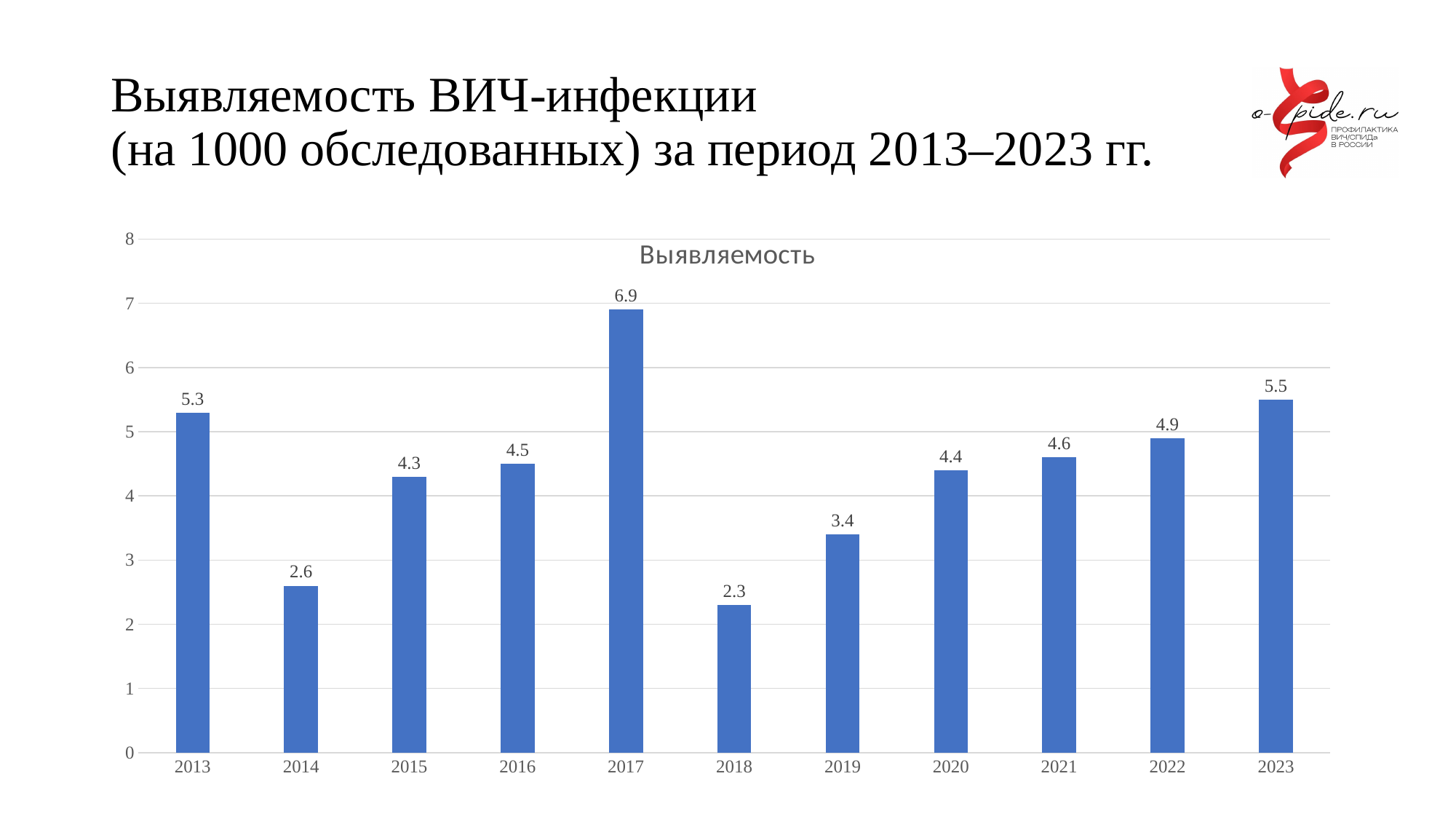
Which is larger, the value for 2013 or the value for 2022? 2013 What is the title shown inside the chart area? Выявляемость What is the value for 2014? 2.6 Do the values rise or fall from 2018 to 2023? rise What is the value for 2023? 5.5 Is the value for 2019 greater or less than 4? less How many years are shown on the x axis? 11 Which year has the highest value? 2017 What is the difference between the values for 2017 and 2018? 4.6 What kind of chart is this? bar chart Which year has the lowest value? 2018 What is the value for 2017? 6.9